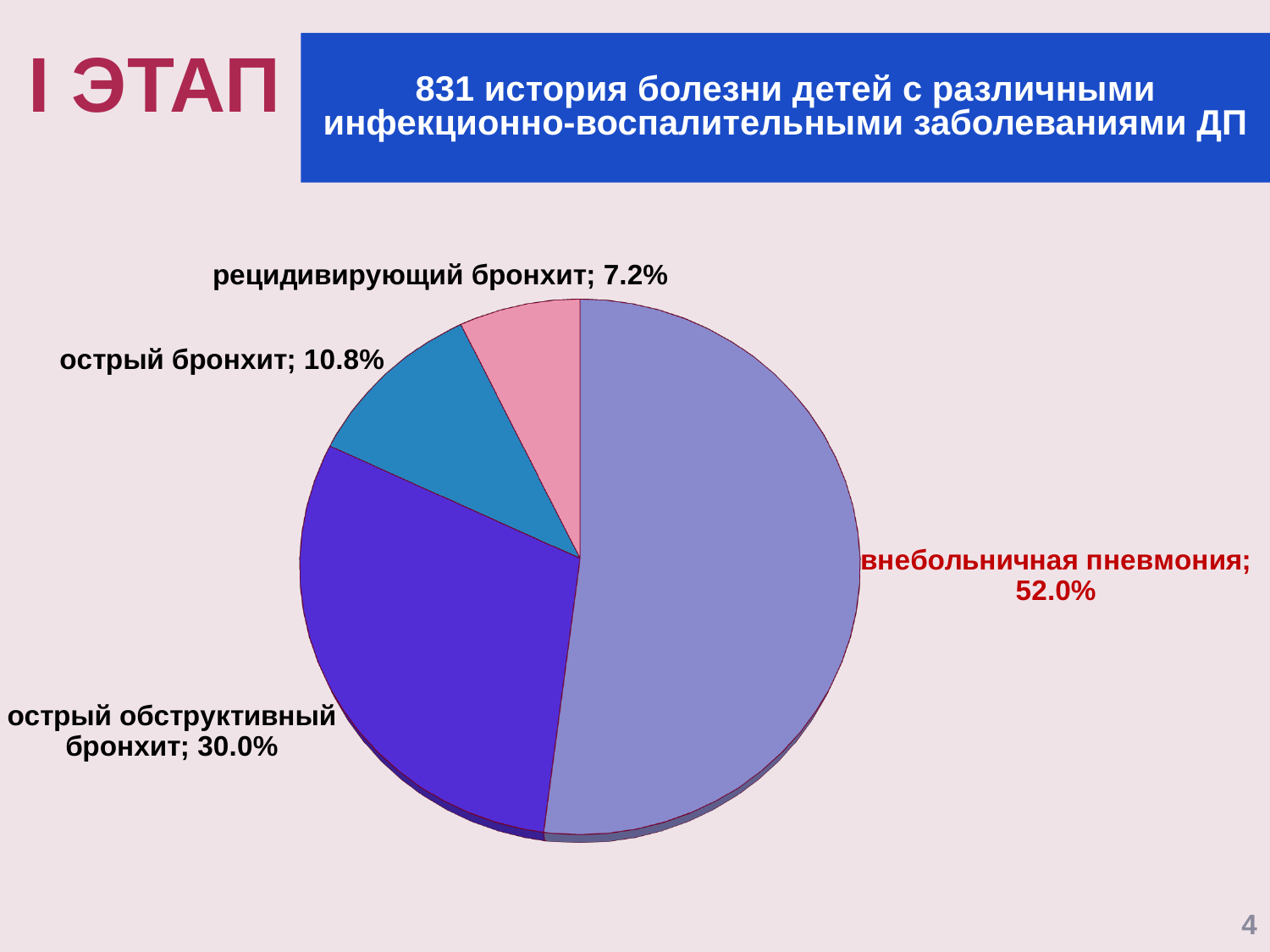
What is the difference between the shares of внебольничная пневмония and острый обструктивный бронхит? 22.0% What is the share for острый бронхит? 10.8% What kind of chart is shown on the slide? pie chart How many categories are shown in the pie chart? 4 What colour is the slice for острый обструктивный бронхит? blue What is the difference between the shares of острый бронхит and рецидивирующий бронхит? 3.6% Which category has the smallest slice of the pie? рецидивирующий бронхит Which category has the largest slice of the pie? внебольничная пневмония What is the share for рецидивирующий бронхит? 7.2% What is the share for острый обструктивный бронхит? 30.0% Which is larger: the share of острый бронхит or the share of рецидивирующий бронхит? острый бронхит What is the share for внебольничная пневмония? 52.0%